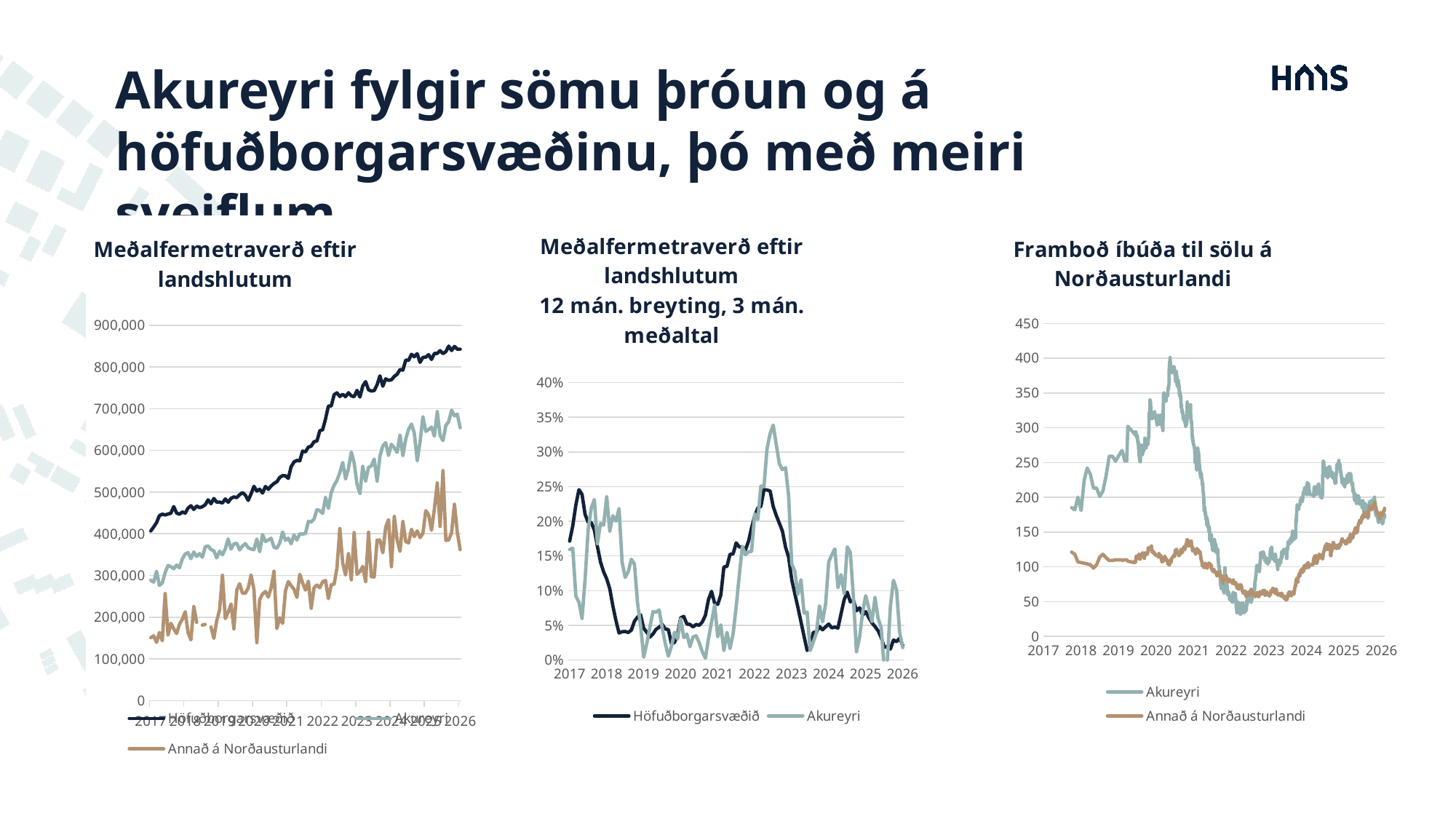
In the right chart 'Framboð íbúða til sölu á Norðausturlandi', is the peak value of the Akureyri series greater or less than 350? greater In the left chart 'Meðalfermetraverð eftir landshlutum', is the value for Höfuðborgarsvæðið at the start of the series (2017) greater or less than 500,000? less In the left chart 'Meðalfermetraverð eftir landshlutum', does the Höfuðborgarsvæðið series rise or fall from 2017 to 2026? rise In the right chart 'Framboð íbúða til sölu á Norðausturlandi', is the lowest value of the Akureyri series (around 2022) greater or less than 100? less How many series does the legend of the middle chart '12 mán. breyting, 3 mán. meðaltal' list? 2 What kind of chart is the left chart titled 'Meðalfermetraverð eftir landshlutum'? line chart In the middle chart '12 mán. breyting, 3 mán. meðaltal', which series reaches the higher peak, Höfuðborgarsvæðið or Akureyri? Akureyri How many series does the legend of the left chart 'Meðalfermetraverð eftir landshlutum' list? 3 What are the two legend entries of the right chart 'Framboð íbúða til sölu á Norðausturlandi'? Akureyri and Annað á Norðausturlandi In the left chart 'Meðalfermetraverð eftir landshlutum', which series has the highest values throughout the period? Höfuðborgarsvæðið